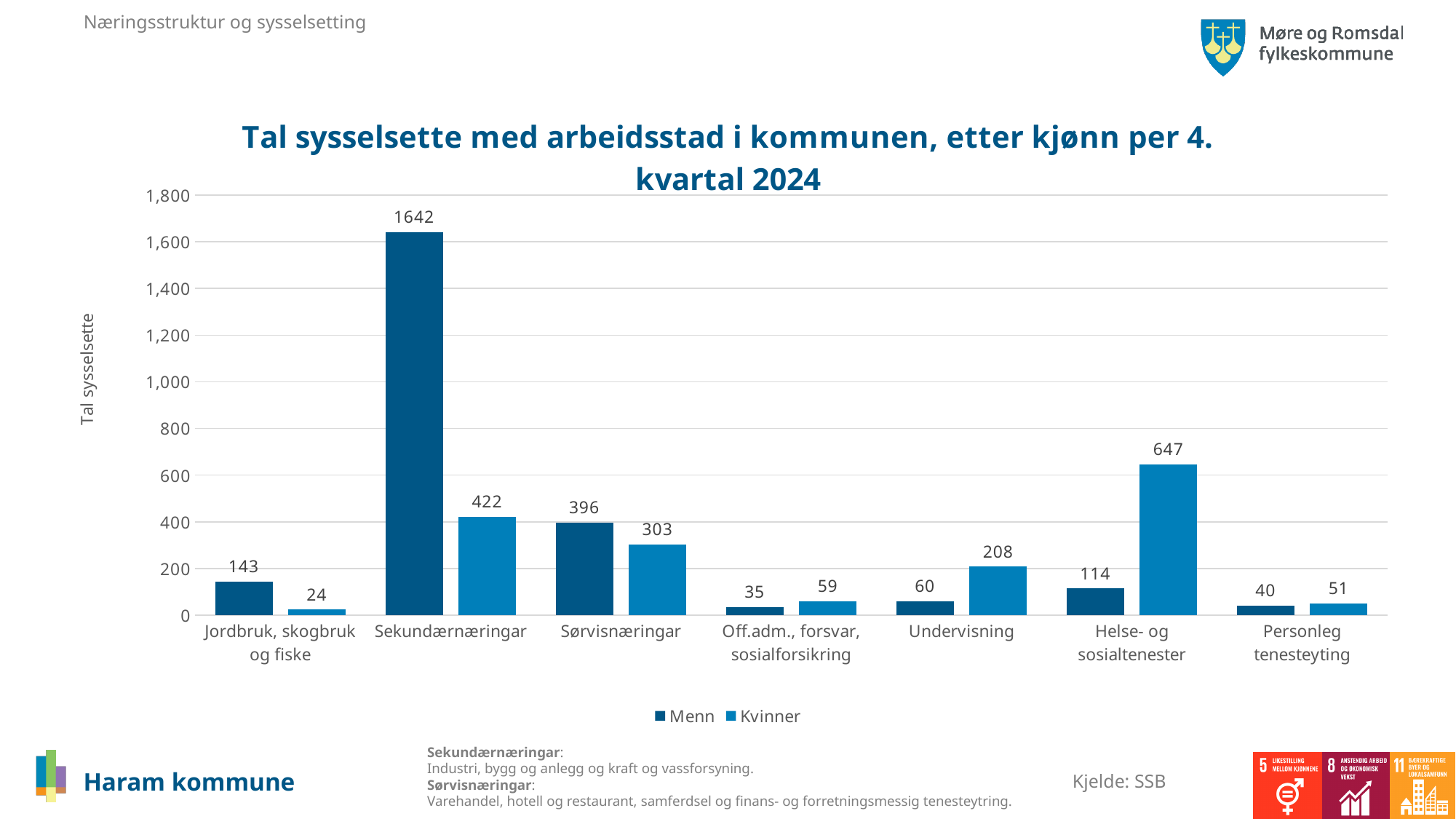
What is the value for Kvinner in Jordbruk, skogbruk og fiske? 24 Is the value for Kvinner in Sekundærnæringar greater or less than 400? greater What is the value for Kvinner in Helse- og sosialtenester? 647 What is the value for Menn in Sekundærnæringar? 1642 How many categories are shown on the x axis? 7 What is the difference between Menn and Kvinner in Sørvisnæringar? 93 What kind of chart is shown on the slide? bar chart Which is larger in Undervisning, Menn or Kvinner? Kvinner Which category has the lowest value for Menn? Off.adm., forsvar, sosialforsikring How many series does the legend list? 2 Which category has the highest value for Kvinner? Helse- og sosialtenester What is the label of the y axis? Tal sysselsette